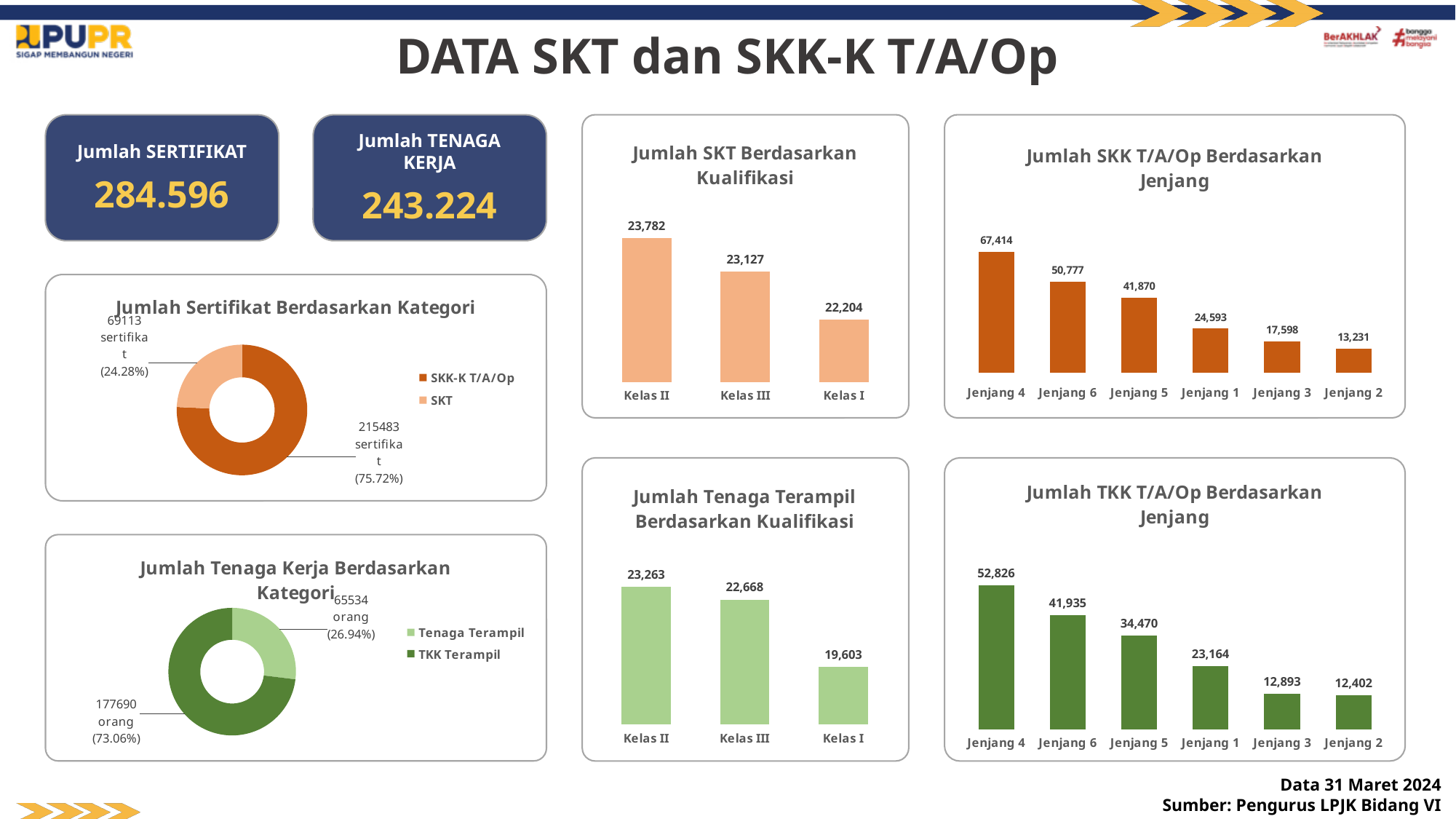
In the 'Jumlah TKK T/A/Op Berdasarkan Jenjang' chart, what is the value for Jenjang 5? 34,470 In the 'Jumlah Sertifikat Berdasarkan Kategori' chart, how many entries does the legend list? 2 In the 'Jumlah TKK T/A/Op Berdasarkan Jenjang' chart, how many jenjang categories are shown? 6 In the 'Jumlah SKK T/A/Op Berdasarkan Jenjang' chart, which jenjang has the lowest value? Jenjang 2 In the 'Jumlah SKT Berdasarkan Kualifikasi' chart, what is the value for Kelas II? 23,782 In the 'Jumlah Tenaga Kerja Berdasarkan Kategori' chart, how many orang are TKK Terampil? 177690 orang In the 'Jumlah SKK T/A/Op Berdasarkan Jenjang' chart, what is the difference between Jenjang 4 and Jenjang 2? 54,183 In the 'Jumlah Tenaga Terampil Berdasarkan Kualifikasi' chart, which is larger: Kelas II or Kelas III? Kelas II In the 'Jumlah Tenaga Terampil Berdasarkan Kualifikasi' chart, which kelas has the lowest value? Kelas I What type of chart is 'Jumlah Tenaga Kerja Berdasarkan Kategori'? Donut (pie) chart In the 'Jumlah Sertifikat Berdasarkan Kategori' chart, what share of certificates is SKK-K T/A/Op? 75.72% In the 'Jumlah SKK T/A/Op Berdasarkan Jenjang' chart, which jenjang has the highest value? Jenjang 4